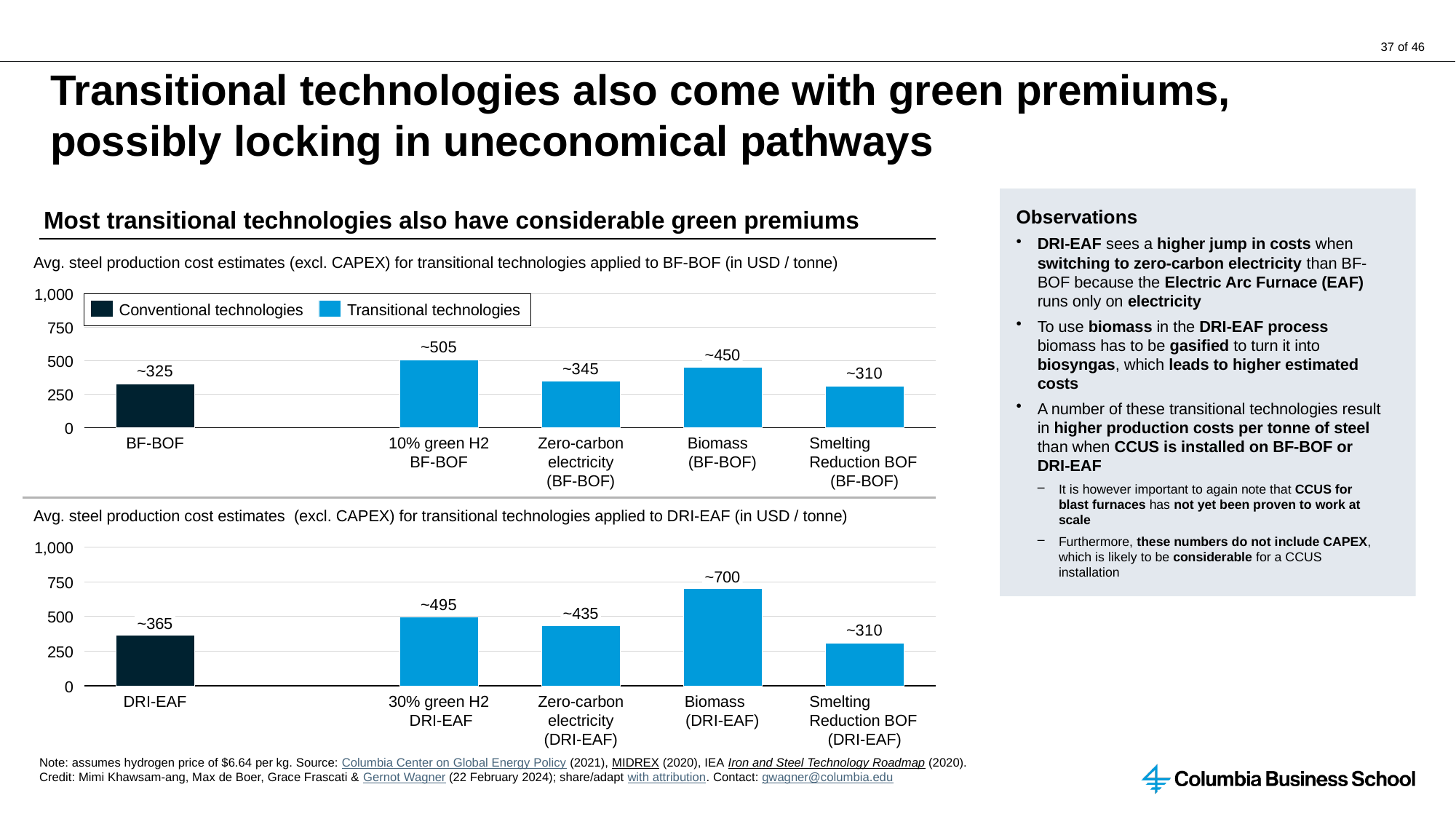
In the top chart (BF-BOF), is the value for Biomass (BF-BOF) greater or less than 250? greater In the top chart (BF-BOF), which category has the lowest cost estimate? Smelting Reduction BOF (BF-BOF) In the bottom chart (DRI-EAF), what is the labelled cost estimate for Biomass (DRI-EAF)? ~700 In the top chart (BF-BOF), what is the labelled cost estimate for 10% green H2 BF-BOF? ~505 In the bottom chart (DRI-EAF), which is larger: the value for 30% green H2 DRI-EAF or the value for Zero-carbon electricity (DRI-EAF)? 30% green H2 DRI-EAF In the bottom chart (DRI-EAF), which category has the lowest cost estimate? Smelting Reduction BOF (DRI-EAF) What type of chart is used in the top chart (BF-BOF) on the slide? Bar chart In the top chart (BF-BOF), which category has the highest cost estimate? 10% green H2 BF-BOF In the top chart (BF-BOF), how many categories are shown on the x axis? 5 How many series does the legend on the top chart list? 2 In the bottom chart (DRI-EAF), which category has the highest cost estimate? Biomass (DRI-EAF) In the bottom chart (DRI-EAF), is the value for Biomass (DRI-EAF) greater or less than 500? greater